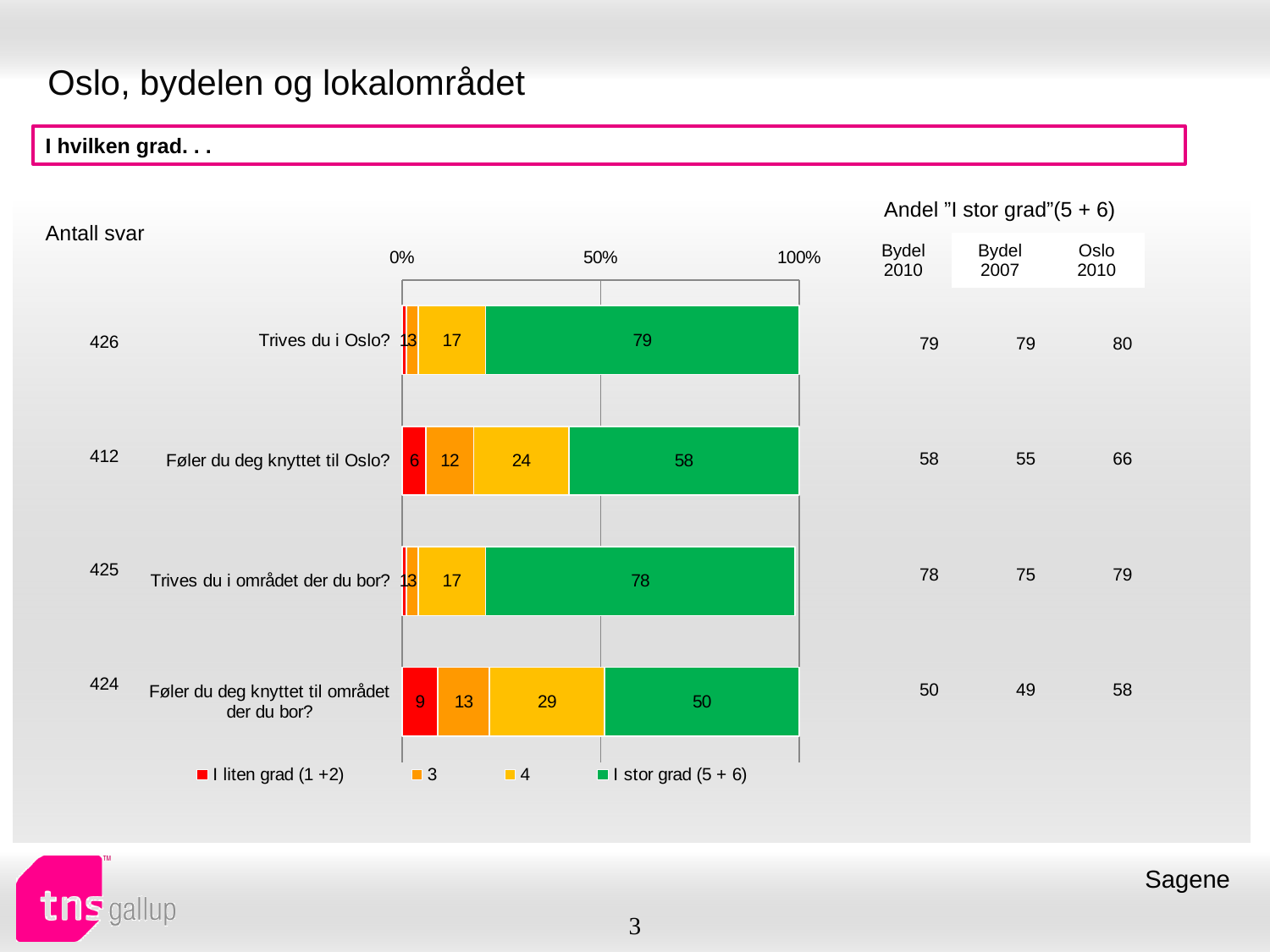
What is the value of the 'I stor grad (5 + 6)' segment for 'Trives du i Oslo?'? 79 What is the value of the '4' segment for 'Føler du deg knyttet til Oslo?'? 24 What is the value of the '3' segment for 'Føler du deg knyttet til området der du bor?'? 13 Which has the larger '4' segment: 'Føler du deg knyttet til Oslo?' or 'Føler du deg knyttet til området der du bor?'? Føler du deg knyttet til området der du bor? What is the difference between the 'I stor grad (5 + 6)' values for 'Føler du deg knyttet til Oslo?' and 'Føler du deg knyttet til området der du bor?'? 8 What is the value of the '3' segment for 'Føler du deg knyttet til Oslo?'? 12 How many series does the legend list? 4 What is the value of the 'I liten grad (1 +2)' segment for 'Føler du deg knyttet til området der du bor?'? 9 How many questions (categories) are shown in the bar chart? 4 Which question has the lowest 'I stor grad (5 + 6)' value? Føler du deg knyttet til området der du bor? Is the 'I stor grad (5 + 6)' value for 'Trives du i området der du bor?' greater or less than 50%? greater What type of chart is shown on the slide? Stacked bar chart